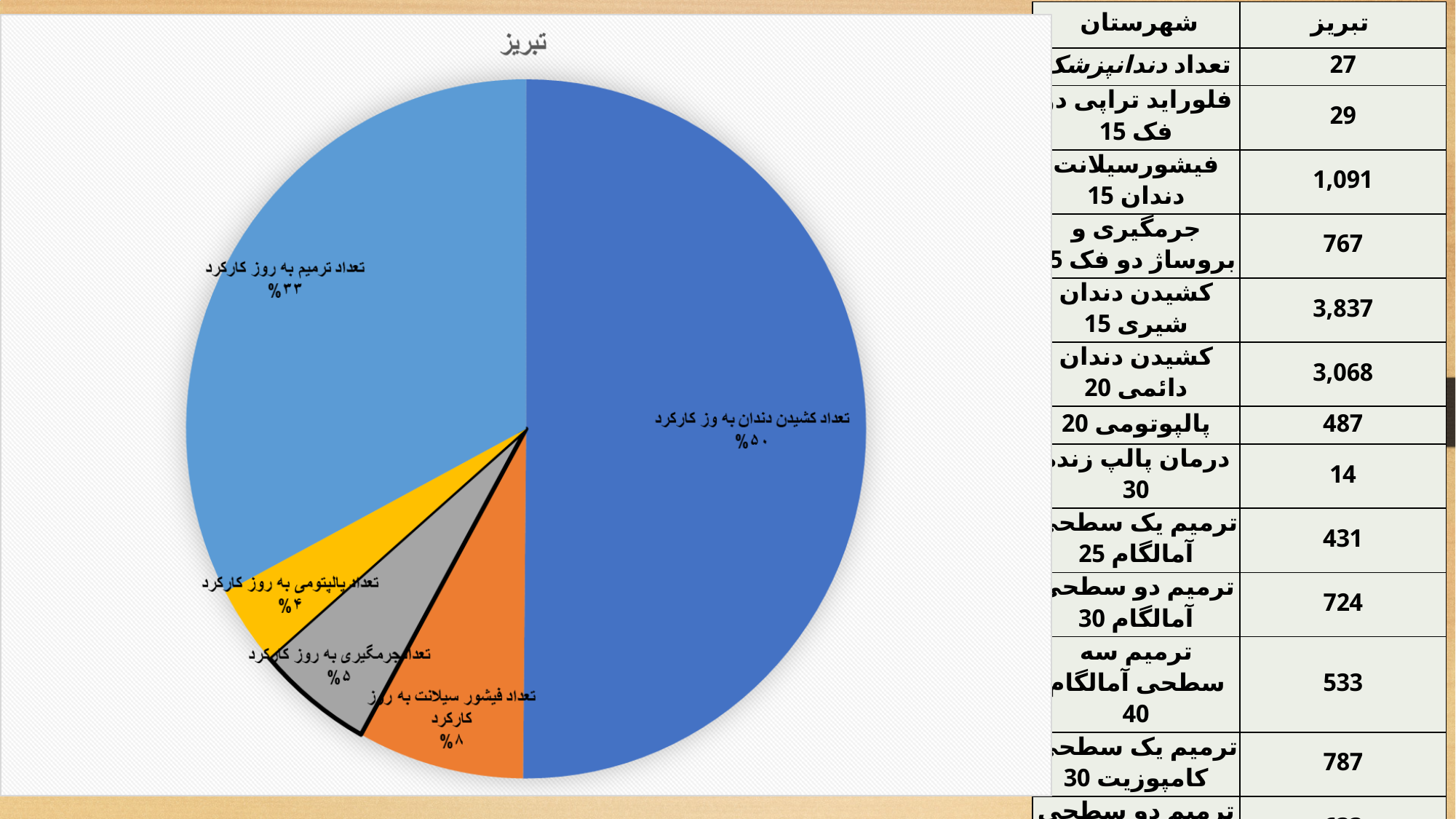
What share of the pie does تعداد پالپتومی به روز کارکرد have? ۴% Which is larger: the share for تعداد فیشور سیلانت به روز کارکرد or the share for تعداد جرمگیری به روز کارکرد? تعداد فیشور سیلانت به روز کارکرد What is the title of the pie chart? تبریز How many slices does the pie chart have? 5 What kind of chart is shown on the slide? pie chart What share of the pie does تعداد ترمیم به روز کارکرد have? ۳۳% Which slice of the pie chart is the largest? تعداد کشیدن دندان به روز کارکرد What share of the pie does تعداد جرمگیری به روز کارکرد have? ۵% Which slice of the pie chart is the smallest? تعداد پالپتومی به روز کارکرد What colour is the slice for تعداد ترمیم به روز کارکرد? light blue